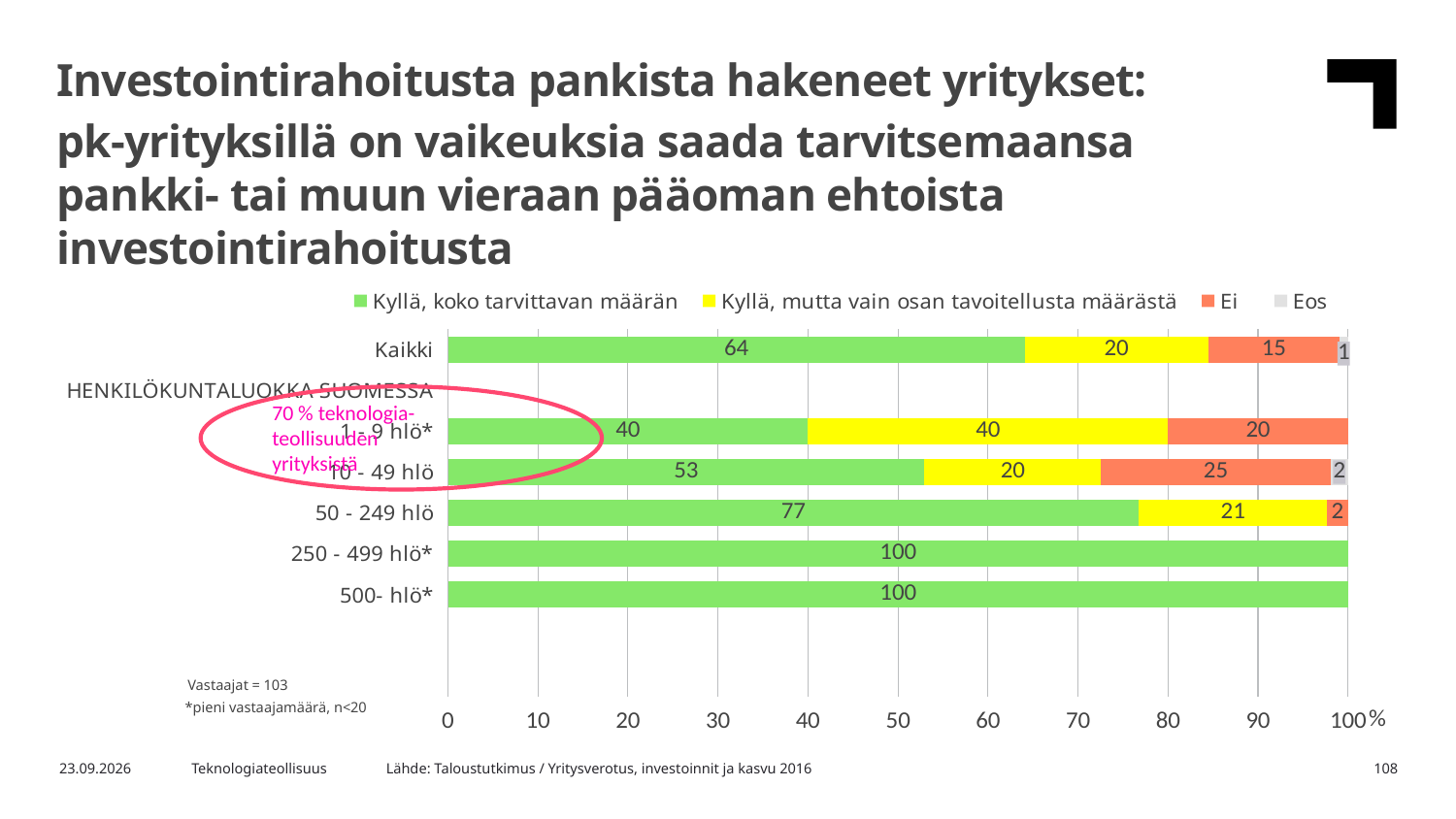
Which is larger: the "Ei" value for "Kaikki" or the "Ei" value for "1 - 9 hlö*"? 1 - 9 hlö* What colour represents the series "Ei" in the chart? orange What is the value of "Kyllä, mutta vain osan tavoitellusta määrästä" for the category "50 - 249 hlö"? 21 What is the value of "Kyllä, koko tarvittavan määrän" for the category "Kaikki"? 64 What is the value of "Eos" for the category "Kaikki"? 1 What type of chart is shown on the slide? stacked bar chart How many series does the legend list? 4 What is the difference between the "Kyllä, koko tarvittavan määrän" values for "50 - 249 hlö" and "10 - 49 hlö"? 24 What is the value of "Ei" for the category "10 - 49 hlö"? 25 What is the value of "Kyllä, koko tarvittavan määrän" for the category "250 - 499 hlö*"? 100 Which category has the lowest value for "Kyllä, koko tarvittavan määrän"? 1 - 9 hlö*